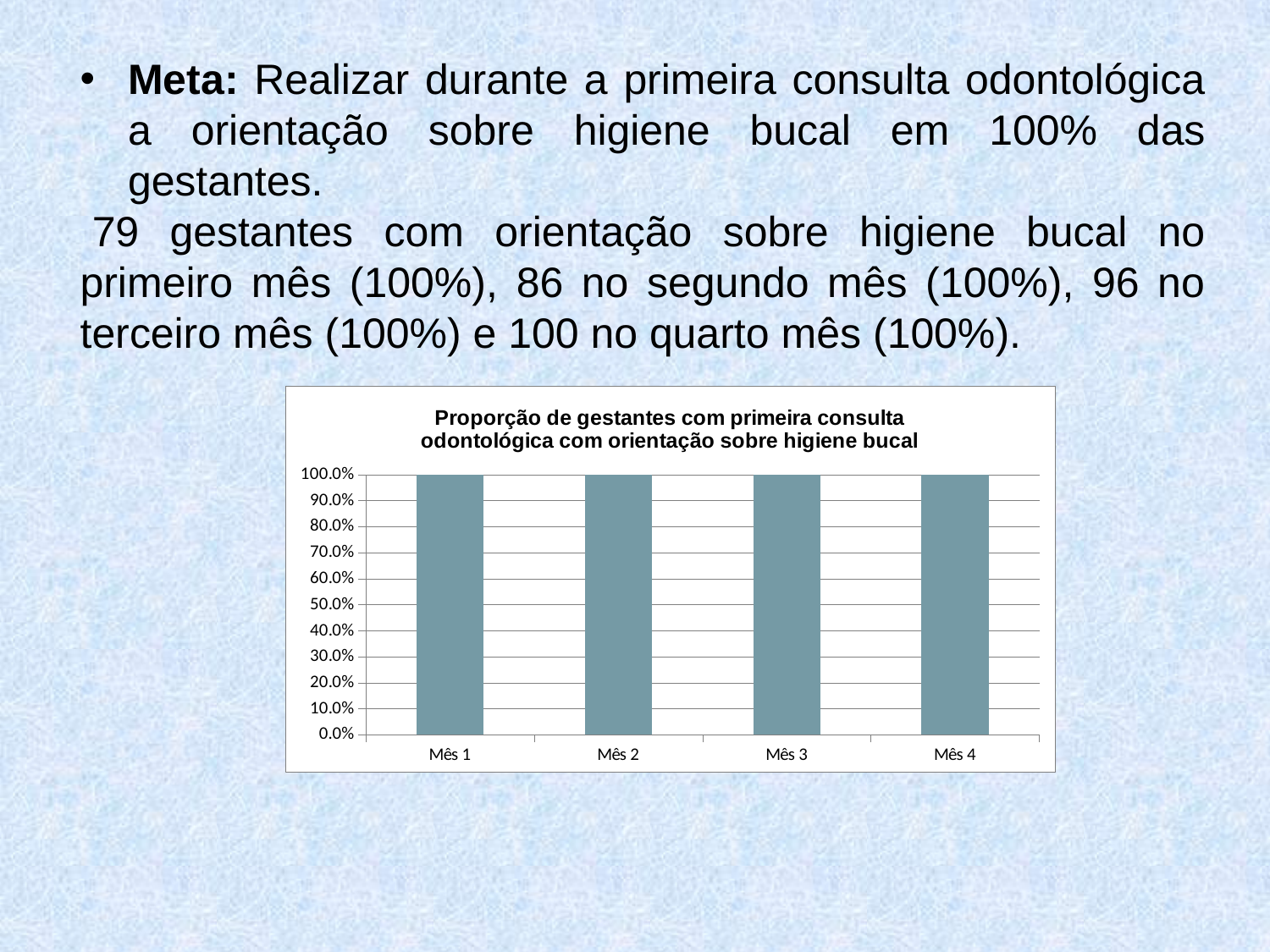
What is the highest value shown on the y axis of the chart? 100.0% What is the value for Mês 3 in the chart? 100.0% What is the value for Mês 4 in the chart? 100.0% What is the value for Mês 1 in the chart? 100.0% Do the values rise, fall, or stay the same from Mês 1 to Mês 4? stay the same Is the value for Mês 4 greater or less than 90.0%? greater How many categories (months) are plotted on the x axis of the chart? 4 What is the difference between the values for Mês 1 and Mês 4? 0.0% Is the value for Mês 2 greater or less than 50.0%? greater What is the title of the chart? Proporção de gestantes com primeira consulta odontológica com orientação sobre higiene bucal What kind of chart is shown on the slide? bar chart